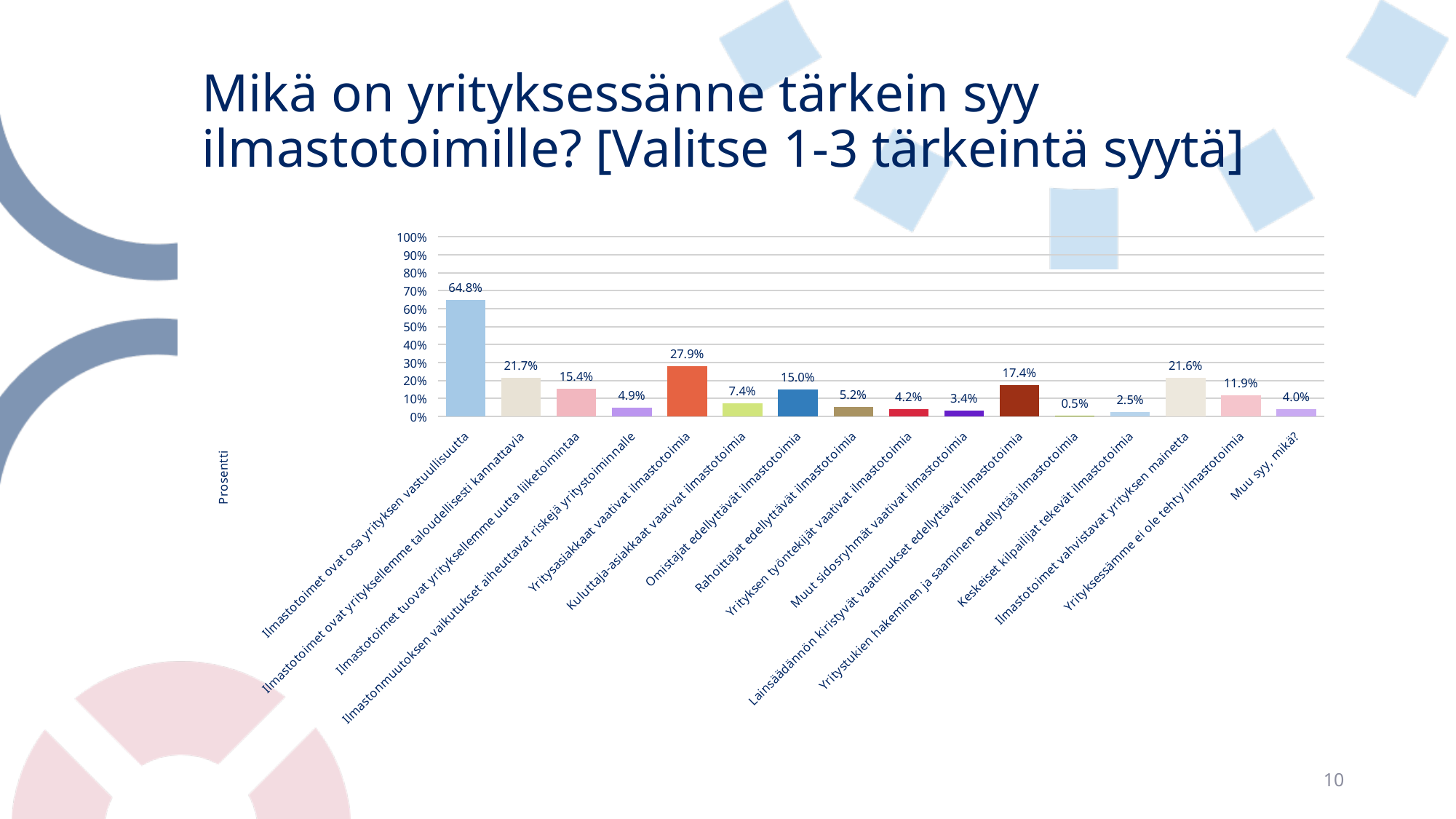
Which category has the highest value? Ilmastotoimet ovat osa yrityksen vastuullisuutta What is the value for "Ilmastotoimet ovat osa yrityksen vastuullisuutta"? 64.8% What is the value for "Yritysasiakkaat vaativat ilmastotoimia"? 27.9% Which category has the lowest value? Yritystukien hakeminen ja saaminen edellyttää ilmastotoimia What is the difference between the values for "Ilmastotoimet ovat osa yrityksen vastuullisuutta" and "Yritysasiakkaat vaativat ilmastotoimia"? 36.9% What is the value for "Lainsäädännön kiristyvät vaatimukset edellyttävät ilmastotoimia"? 17.4% What is the label of the vertical axis? Prosentti How many categories are shown on the x axis? 16 What kind of chart is shown on the slide? bar chart Is the value for "Ilmastotoimet vahvistavat yrityksen mainetta" greater or less than 30%? less What is the value for "Yrityksessämme ei ole tehty ilmastotoimia"? 11.9% Which is larger: the value for "Omistajat edellyttävät ilmastotoimia" or the value for "Kuluttaja-asiakkaat vaativat ilmastotoimia"? Omistajat edellyttävät ilmastotoimia